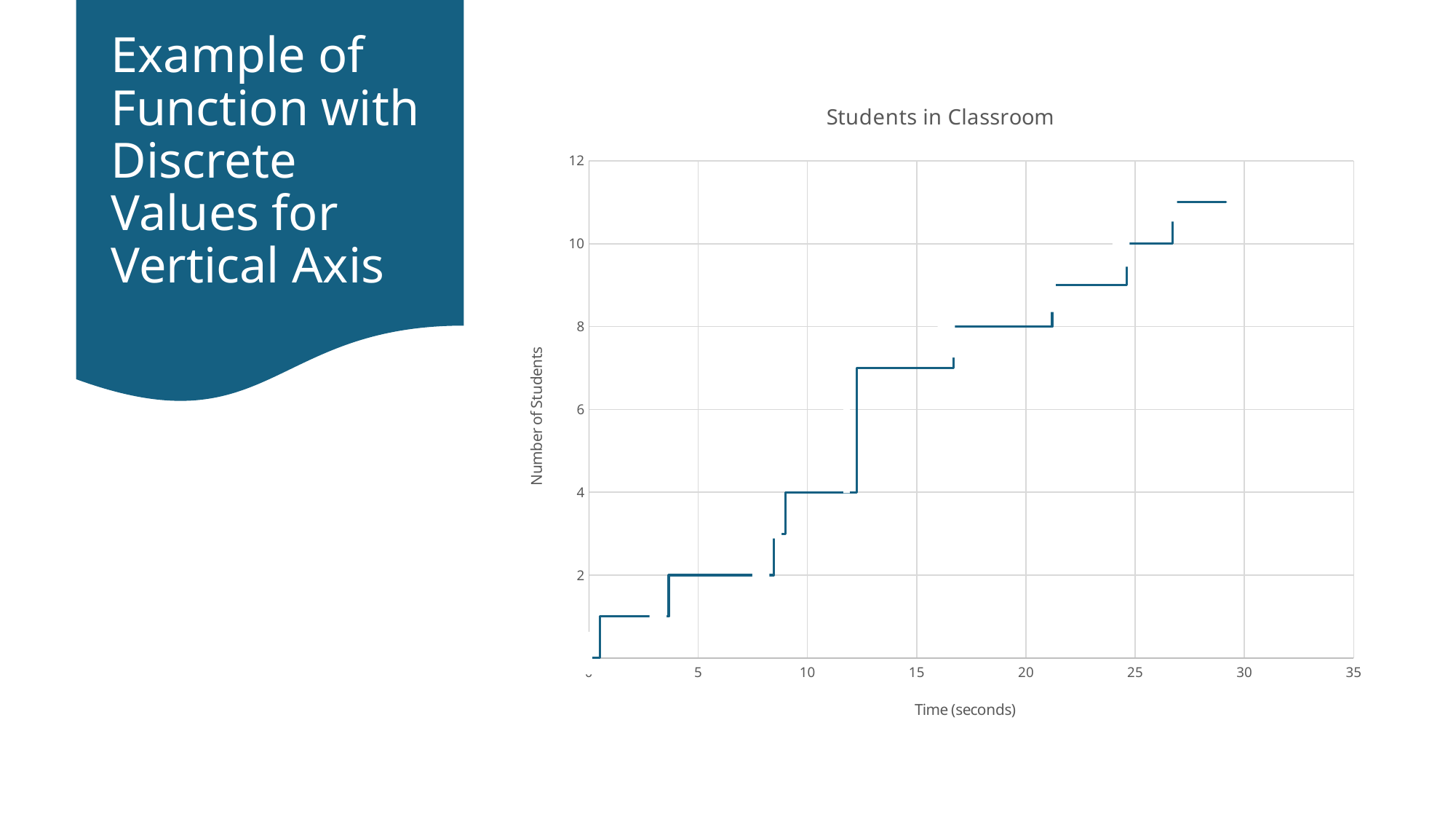
Which is larger, the number of students at 10 seconds or at 20 seconds? 20 seconds What kind of chart is shown on the slide? line chart What is the number of students at 20 seconds? 8 Is the number of students at 28 seconds greater or less than 10? greater What is the label of the horizontal axis? Time (seconds) What is the number of students at 25 seconds? 10 What is the number of students at 10 seconds? 4 Does the number of students rise or fall as time increases? rises What is the number of students at 5 seconds? 2 Is the number of students at 15 seconds greater or less than 6? greater Is the number of students at 2 seconds greater or less than 2? less What is the title of the chart? Students in Classroom